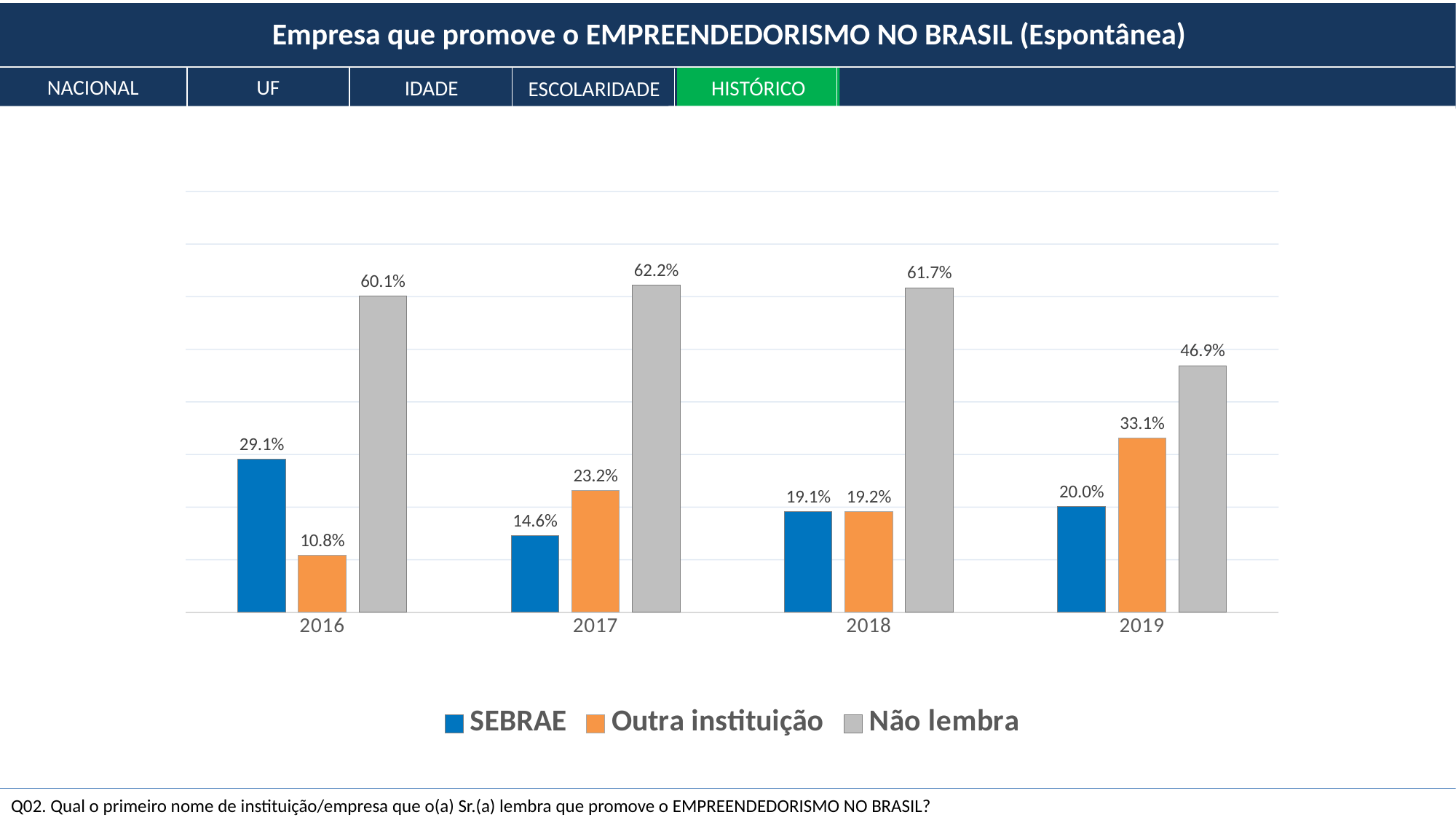
In which year is the SEBRAE value lowest? 2017 What kind of chart is shown on the slide? Bar chart Which colour represents Não lembra in the legend? Grey What is the value for SEBRAE in 2016? 29.1% How many years are shown on the x axis? 4 What is the value for Outra instituição in 2019? 33.1% Which is larger in 2016: SEBRAE or Outra instituição? SEBRAE What is the value for Não lembra in 2017? 62.2% In which year is the Não lembra value highest? 2017 How many series does the legend list? 3 Does the Outra instituição value rise or fall from 2016 to 2019? Rise What is the difference between the Não lembra values in 2018 and 2019? 14.8%